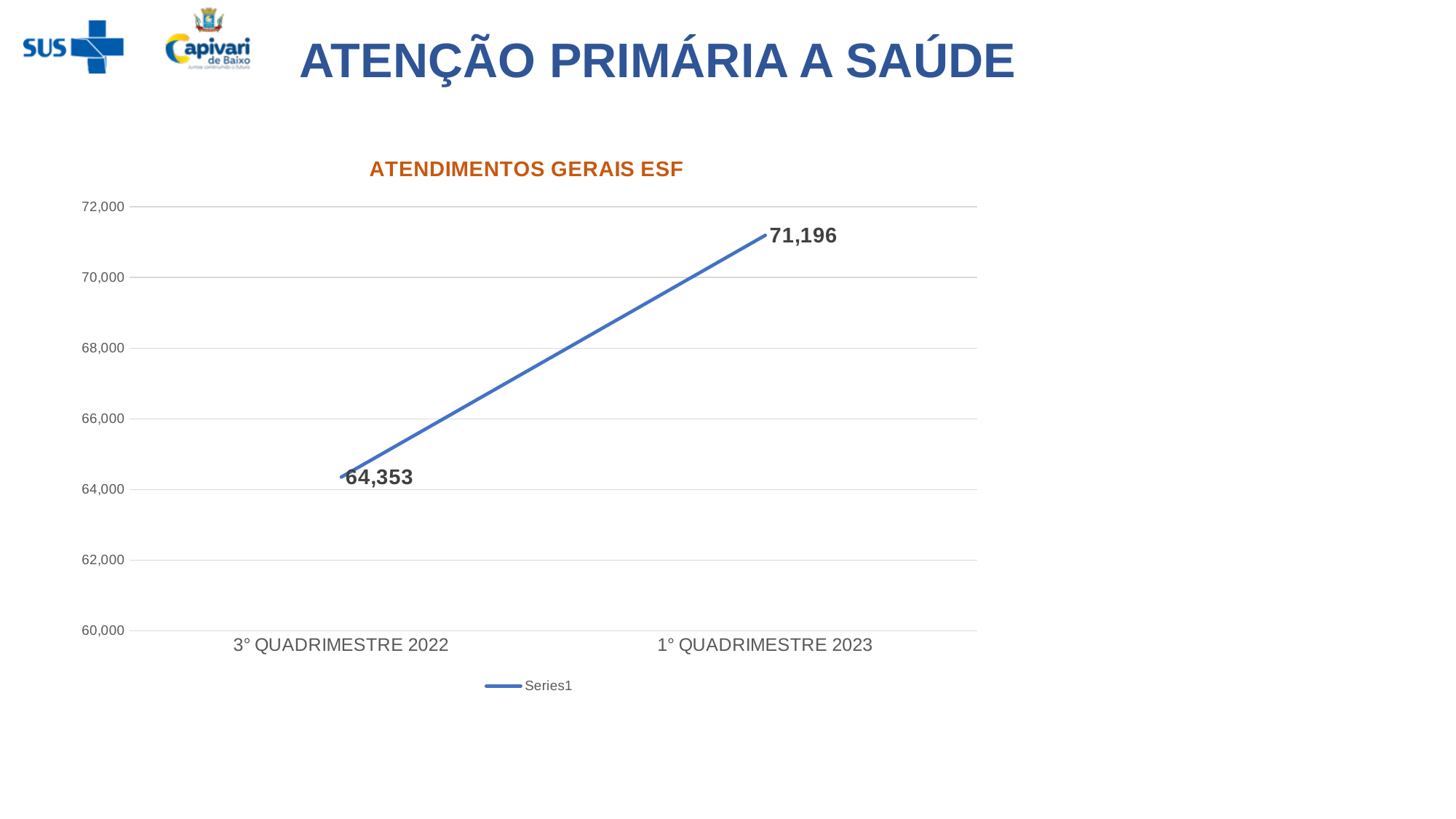
What is the value for 3° QUADRIMESTRE 2022? 64,353 Do the values rise or fall from 3° QUADRIMESTRE 2022 to 1° QUADRIMESTRE 2023? rise How many series does the legend list? 1 Which category has the lowest value? 3° QUADRIMESTRE 2022 How many data points are plotted on the chart? 2 Which is larger, the value for 3° QUADRIMESTRE 2022 or the value for 1° QUADRIMESTRE 2023? 1° QUADRIMESTRE 2023 What is the value for 1° QUADRIMESTRE 2023? 71,196 What is the difference between the values for 1° QUADRIMESTRE 2023 and 3° QUADRIMESTRE 2022? 6,843 Is the value for 1° QUADRIMESTRE 2023 greater or less than 70,000? greater What kind of chart is shown on the slide? line chart Which category has the highest value? 1° QUADRIMESTRE 2023 Is the value for 3° QUADRIMESTRE 2022 greater or less than 66,000? less